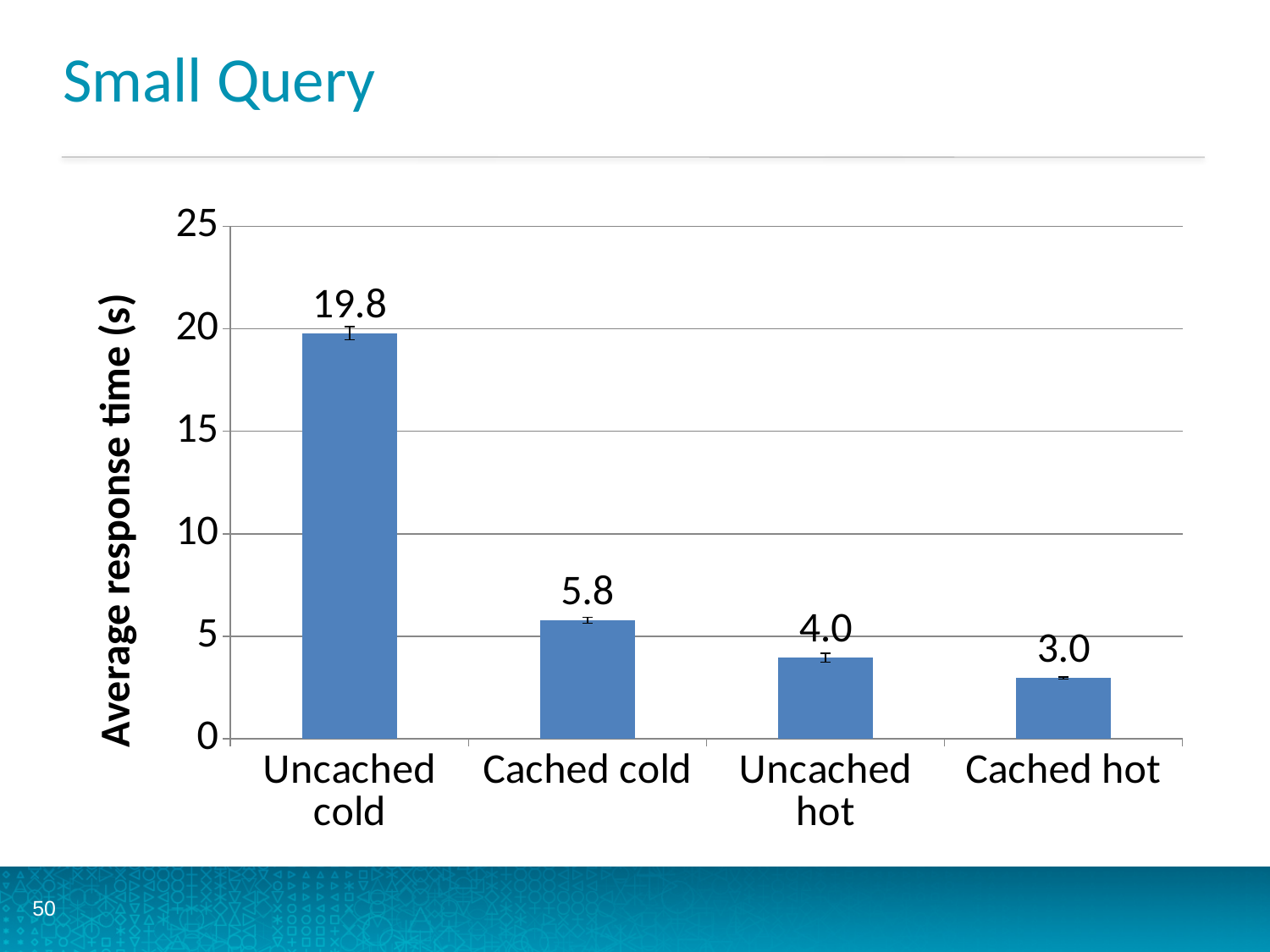
What is the difference in average response time between Uncached cold and Cached cold? 14.0 Which category has the highest average response time? Uncached cold What kind of chart is shown on the slide? Bar chart How many categories are shown on the x axis? 4 What is the average response time for Cached cold? 5.8 Which has a larger average response time, Cached cold or Uncached hot? Cached cold What is the difference in average response time between Uncached hot and Cached hot? 1.0 What is the label of the vertical axis? Average response time (s) Which category has the lowest average response time? Cached hot What is the average response time for Uncached hot? 4.0 What is the average response time for Uncached cold? 19.8 What is the average response time for Cached hot? 3.0